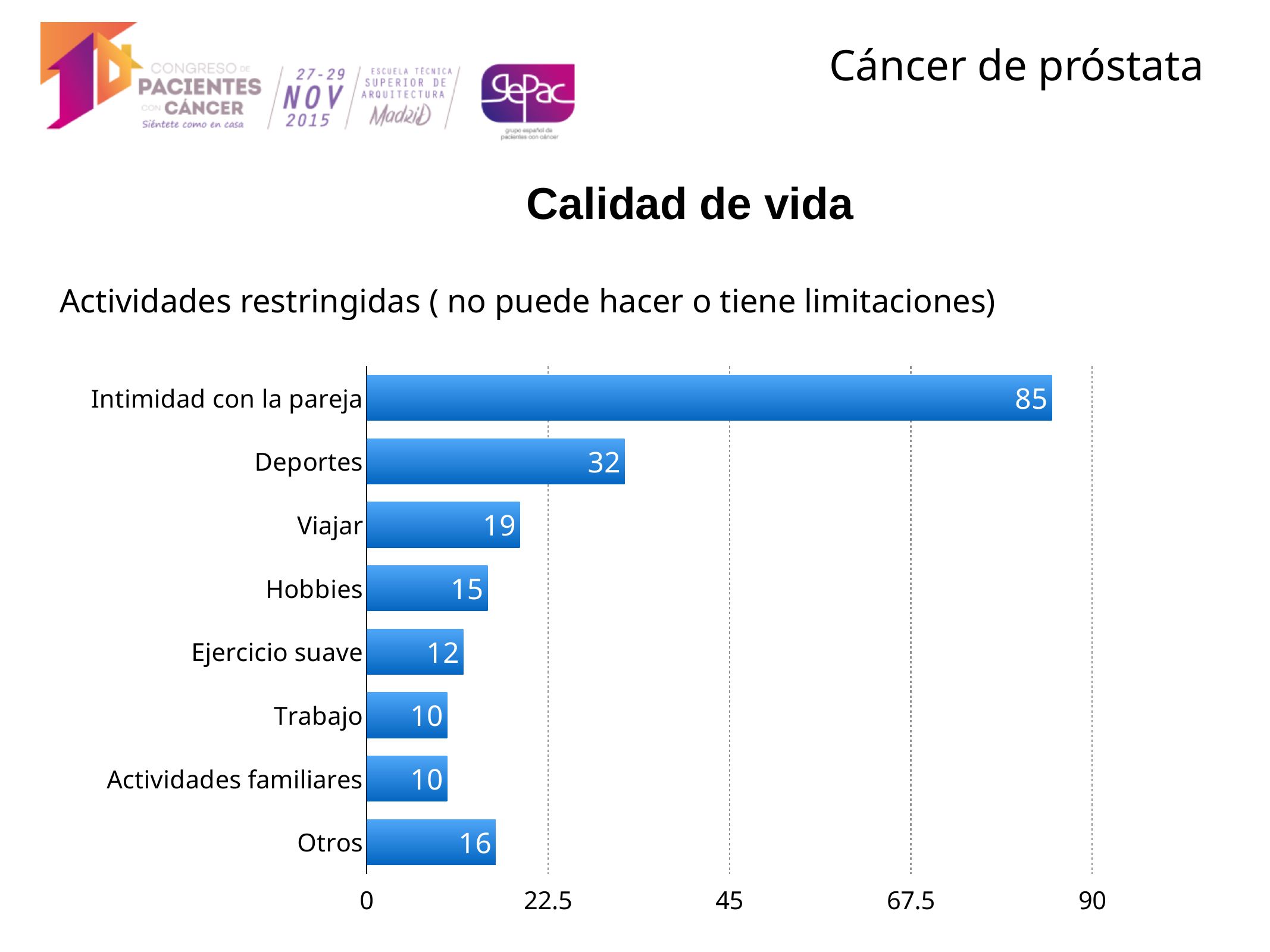
What is the value for Intimidad con la pareja? 85 Is the value for Deportes greater or less than 22.5? greater What is the value for Deportes? 32 What kind of chart is shown on the slide? bar chart How many categories are shown in the chart? 8 What is the value for Viajar? 19 Which category has the highest value? Intimidad con la pareja What is the difference between the values for Viajar and Hobbies? 4 What is the text shown above the chart describing what it plots? Actividades restringidas ( no puede hacer o tiene limitaciones) Which is larger, the value for Ejercicio suave or the value for Otros? Otros What is the value for Otros? 16 What is the difference between the values for Intimidad con la pareja and Deportes? 53